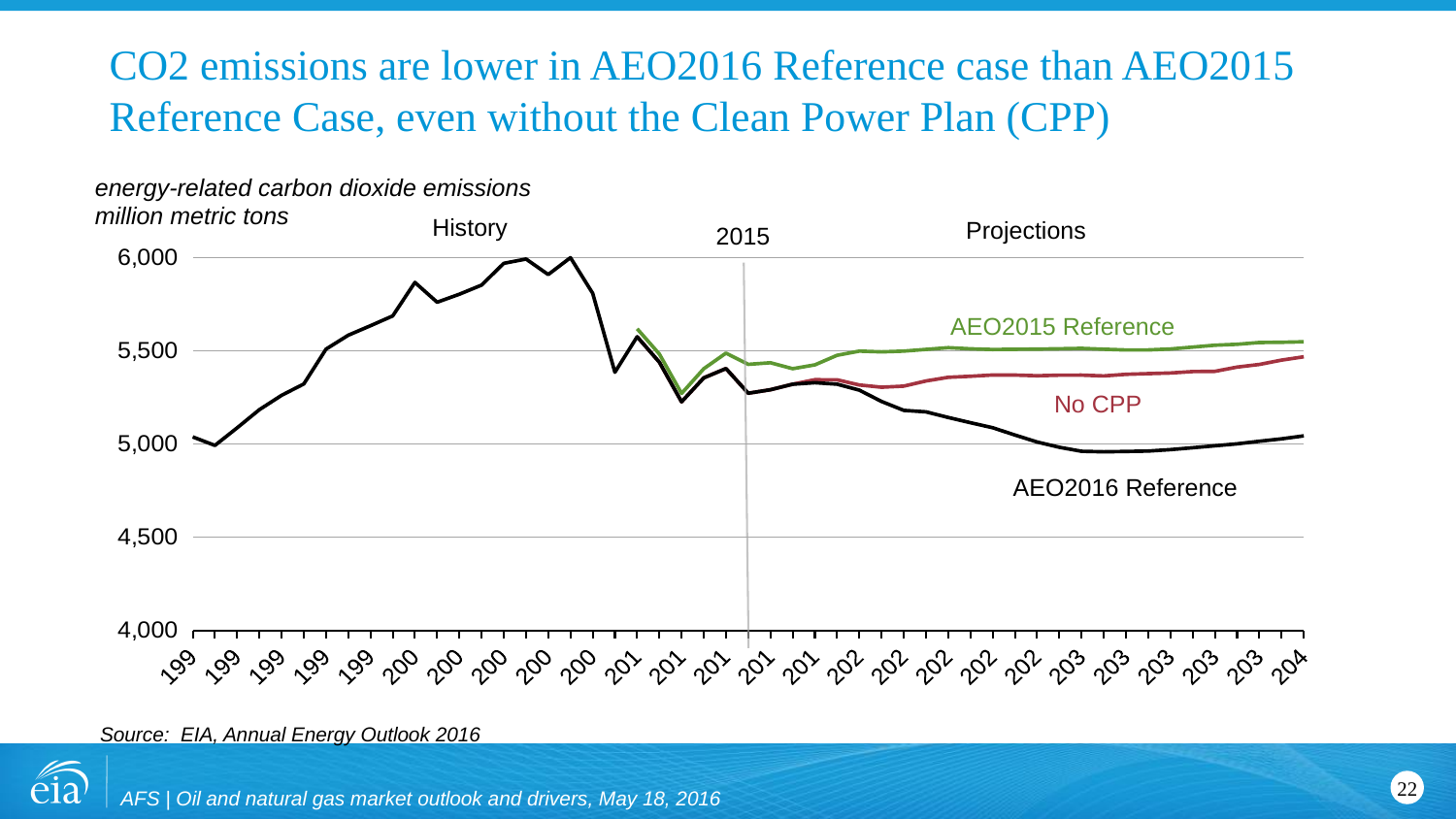
What kind of chart is shown on the slide? line chart What unit is used for the y axis of the chart? million metric tons At the end of the projection period, which is higher: No CPP or AEO2016 Reference? No CPP Is the value for AEO2015 Reference in the projection period greater or less than 5,000? greater Is the value for AEO2016 Reference in the projection period greater or less than 5,500? less Which series is the highest in the projection period? AEO2015 Reference How many series are plotted on the chart? 3 What year does the vertical line separating History from Projections mark? 2015 At the end of the projection period, which is higher: AEO2015 Reference or AEO2016 Reference? AEO2015 Reference Does the AEO2016 Reference line rise or fall from 2015 to around 2030? fall Which series is the lowest in the projection period? AEO2016 Reference Does the history line generally rise or fall from 1990 to the mid-2000s? rise